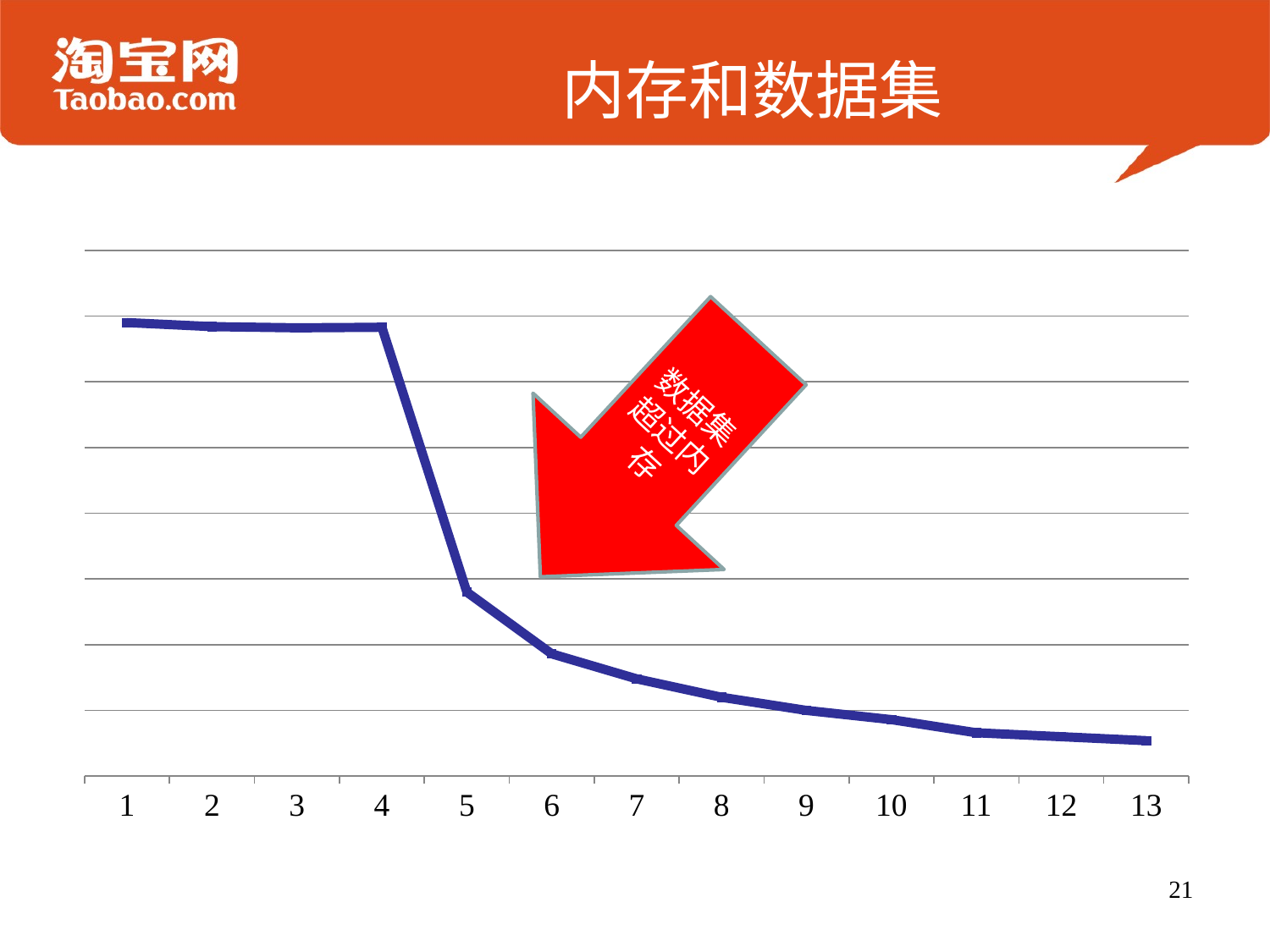
What kind of chart is shown on the slide? line chart What is the title of the slide containing the chart? 内存和数据集 Which has the larger value, point 6 or point 13? 6 Between which two consecutive x-axis points does the line drop most sharply? 4 and 5 Which has the larger value, point 4 or point 5? 4 How many points are plotted along the x axis of the chart? 13 Which has the larger value, point 2 or point 8? 2 At which x-axis point is the plotted value lowest? 13 Do the values in the chart generally rise or fall as the x axis goes from 1 to 13? fall What text is written on the red arrow pointing at the drop in the line? 数据集超过内存